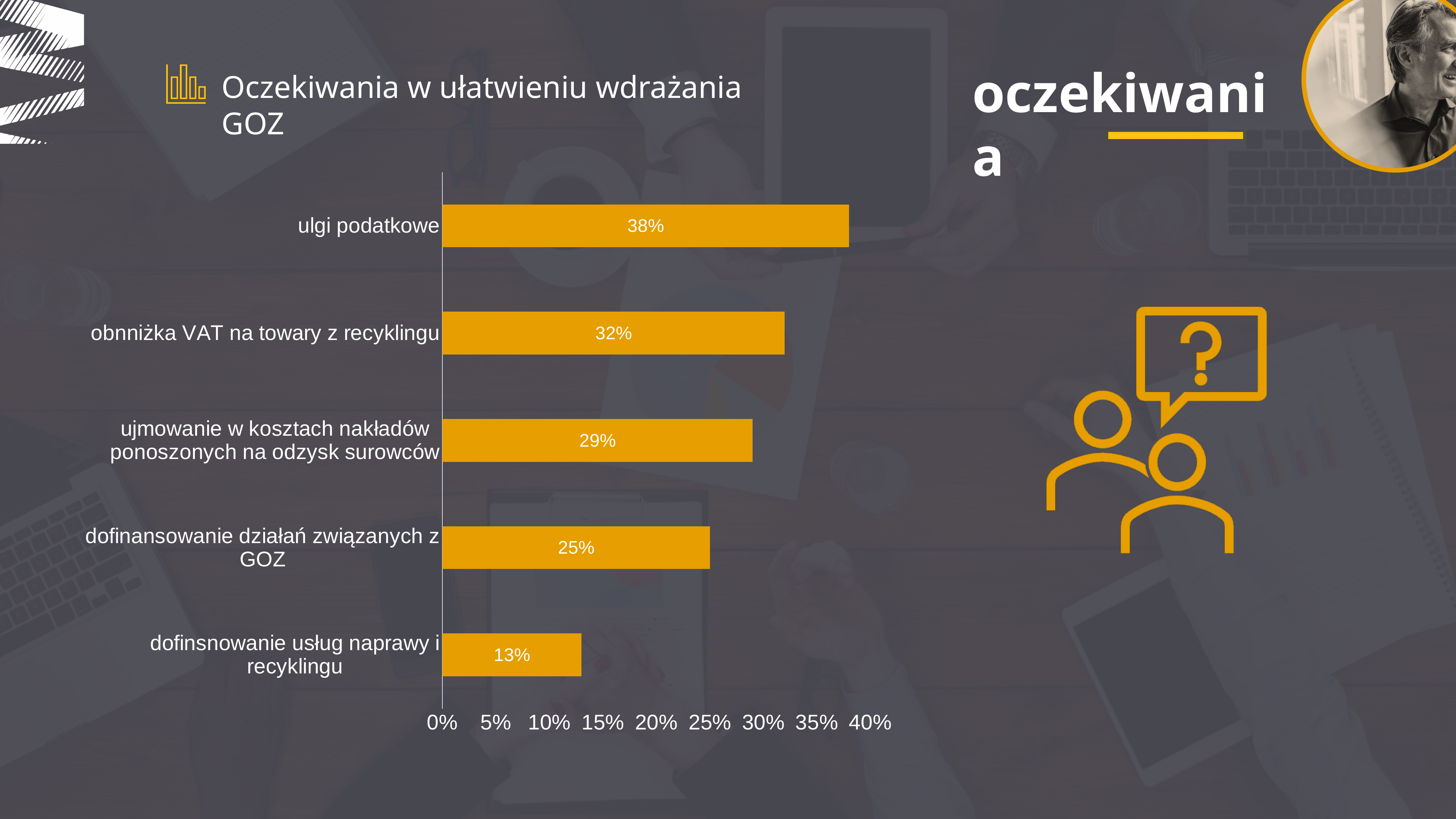
Is the value for "ujmowanie w kosztach nakładów ponoszonych na odzysk surowców" greater or less than 25%? greater Which category has the highest value? ulgi podatkowe Which is larger: the value for "ujmowanie w kosztach nakładów ponoszonych na odzysk surowców" or the value for "dofinansowanie działań związanych z GOZ"? ujmowanie w kosztach nakładów ponoszonych na odzysk surowców What kind of chart is shown on the slide? bar chart What is the value for "obnniżka VAT na towary z recyklingu"? 32% What is the value for "dofinansowanie działań związanych z GOZ"? 25% What is the difference between the values for "ulgi podatkowe" and "obnniżka VAT na towary z recyklingu"? 6% What is the title of the chart? Oczekiwania w ułatwieniu wdrażania GOZ How many categories are shown in the chart? 5 What is the value for "ulgi podatkowe"? 38% What is the value for "dofinsnowanie usług naprawy i recyklingu"? 13% Which category has the lowest value? dofinsnowanie usług naprawy i recyklingu